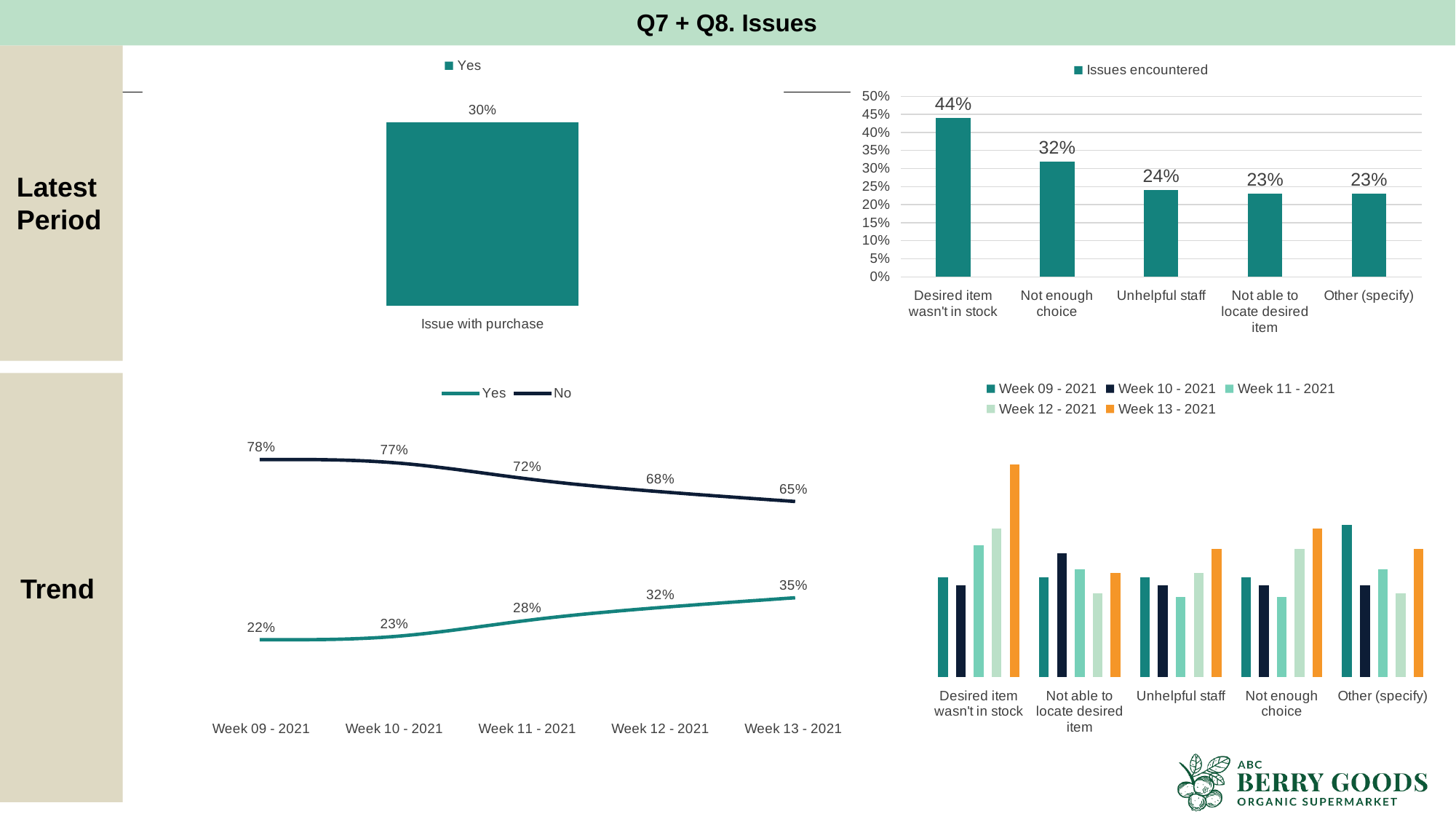
In the bottom-left line chart, what is the No value for Week 13 - 2021? 65% In the top-right Issues encountered chart, what is the value for Not enough choice? 32% In the bottom-right grouped bar chart, how many series does the legend list? 5 In the bottom-left line chart, does the Yes series rise or fall from Week 09 - 2021 to Week 13 - 2021? rise In the top-right Issues encountered chart, what is the difference between Desired item wasn't in stock and Unhelpful staff? 20% In the bottom-left line chart, what is the Yes value for Week 11 - 2021? 28% In the bottom-left line chart, which is larger at Week 10 - 2021, Yes or No? No In the top-right Issues encountered chart, which category has the highest value? Desired item wasn't in stock In the top-right Issues encountered chart, is the value for Unhelpful staff greater or less than 20%? greater What kind of chart is the bottom-left chart? line chart In the top-right Issues encountered chart, how many categories are shown? 5 In the top-left chart, what is the value for Issue with purchase? 30%